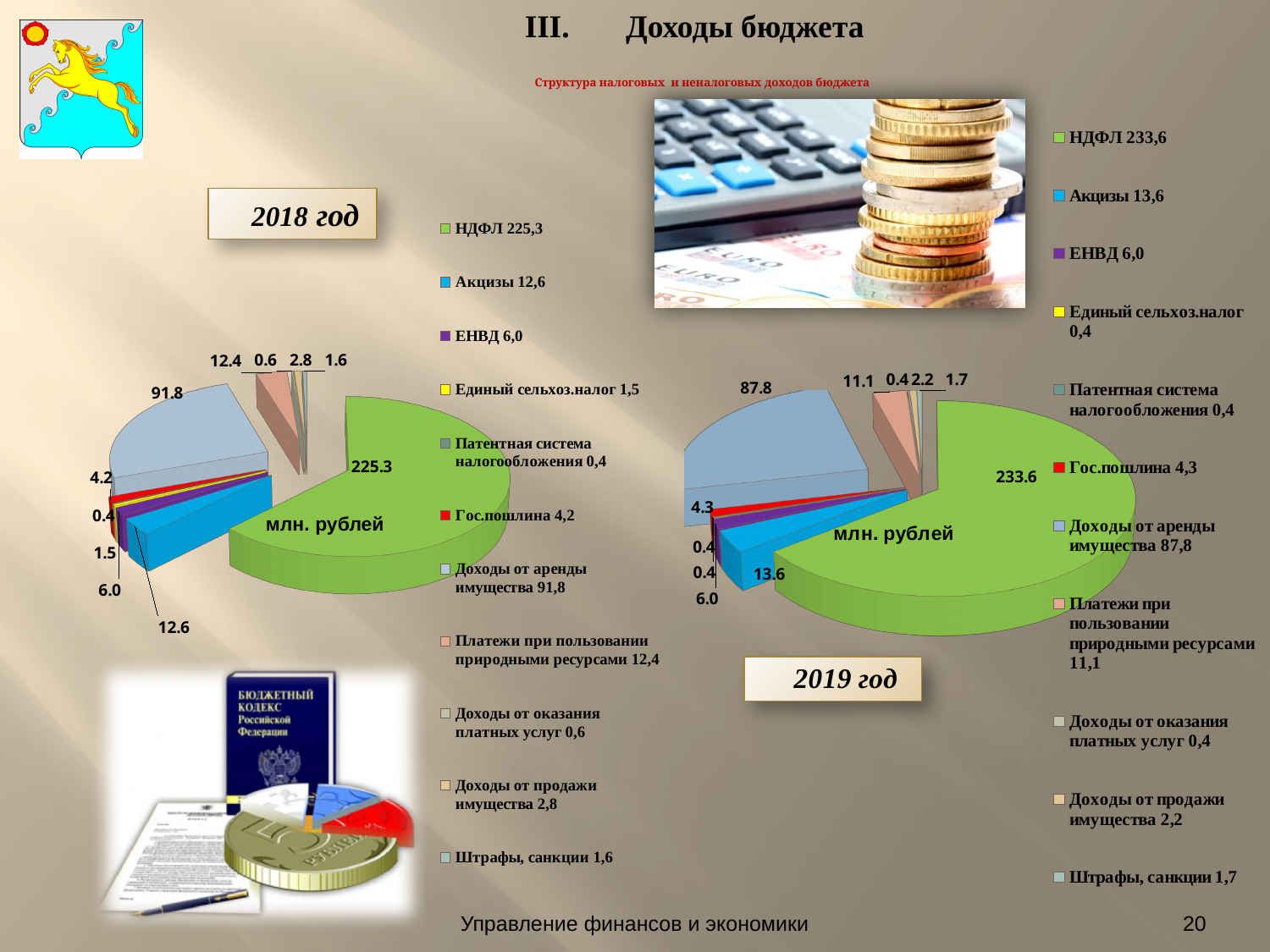
What type of chart is used to show the 2018 budget revenue structure? pie chart How many entries does the legend of the 2018 pie chart list? 11 In the 2018 pie chart, what is the difference between НДФЛ and Доходы от аренды имущества? 133.5 What unit label is printed inside both pie charts? млн. рублей In the 2019 pie chart, what is the value for Акцизы? 13.6 In the 2019 pie chart, what is the value for Доходы от аренды имущества? 87.8 How much larger is НДФЛ in the 2019 pie chart than in the 2018 pie chart? 8.3 In the 2018 pie chart, which category has the largest value? НДФЛ How many categories are shown in the 2019 pie chart? 11 In the 2018 pie chart, what is the value for НДФЛ? 225.3 Which is larger: Платежи при пользовании природными ресурсами in the 2018 chart or in the 2019 chart? 2018 In the 2018 pie chart, which category has the smallest value? Патентная система налогообложения